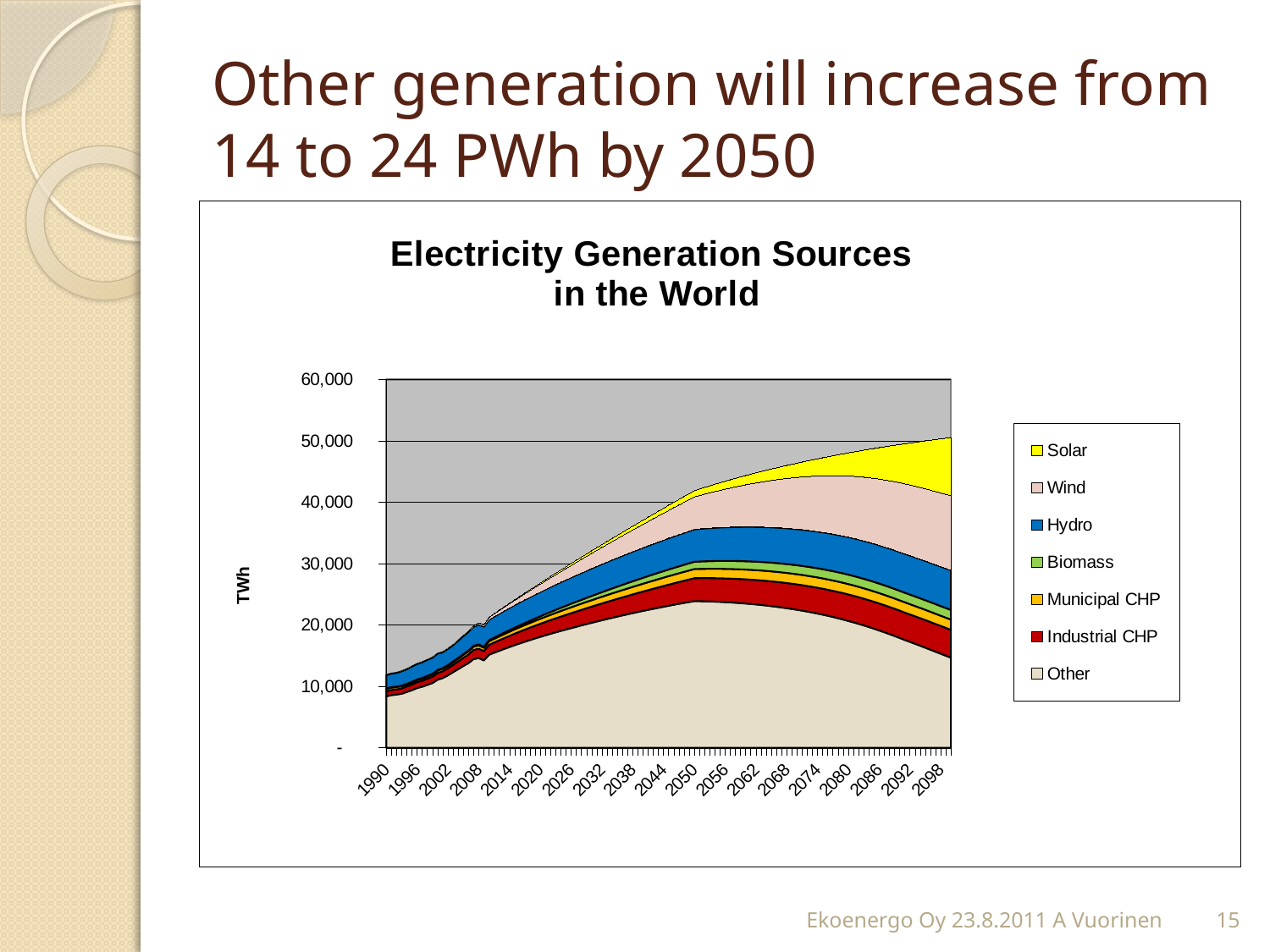
What kind of chart is shown on the slide? Stacked area chart What unit is shown on the vertical axis of the chart? TWh Does the Other generation area rise or fall between 2050 and 2098? fall Is the value for Other generation in 2050 greater or less than 20,000 TWh? greater What is the title of the chart? Electricity Generation Sources in the World Is the value for Other generation in 1990 greater or less than 10,000 TWh? less Is the total electricity generation in 2050 greater or less than 40,000 TWh? greater Does the total electricity generation rise or fall between 1990 and 2050? rise Which series is stacked at the top of the chart in 2098? Solar How many series does the legend of the chart list? 7